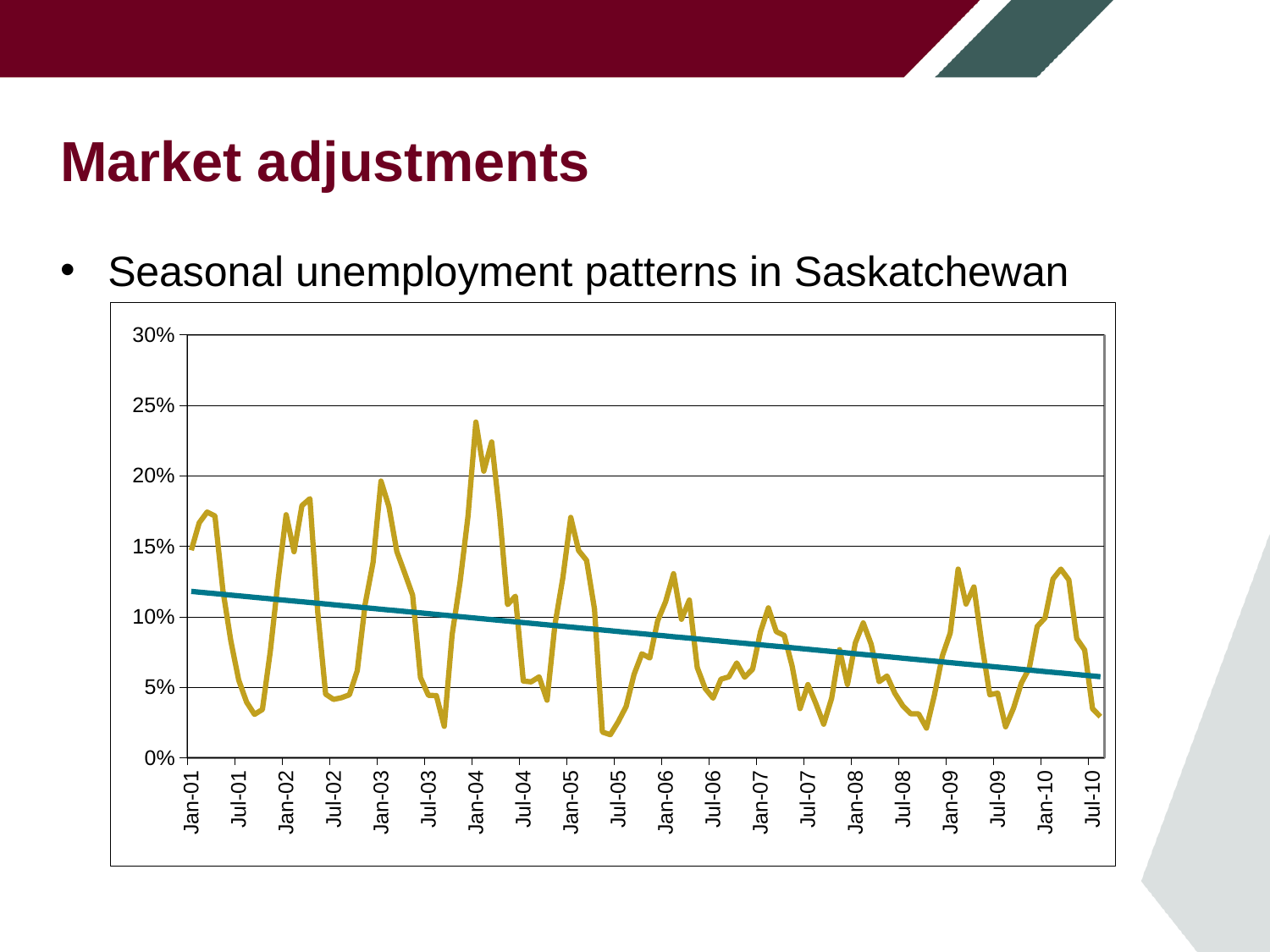
Is the peak of the seasonal line near Jan-05 greater or less than 15%? greater What kind of chart is shown on the slide? line chart Is the value of the trend line at Jan-01 greater or less than 10%? greater Around which x-axis label does the seasonal unemployment line reach its highest peak? Jan-04 What is the highest value shown on the y axis? 30% What colour is the straight trend line on the chart? teal How many labels are shown on the x axis? 20 Is the peak of the seasonal line near Jan-10 greater or less than 15%? less Does the straight trend line rise or fall from Jan-01 to Jul-10? fall